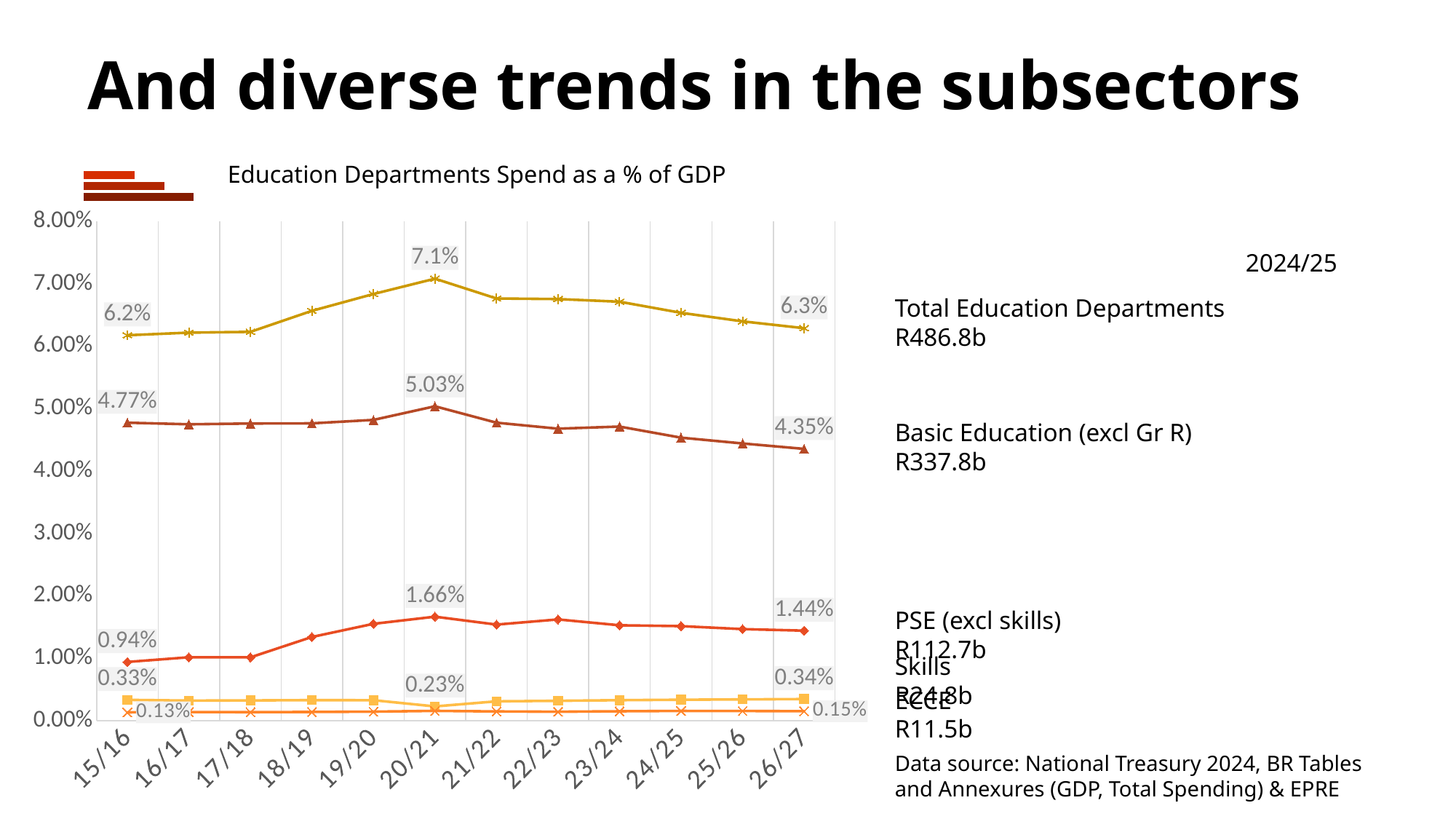
What is the Skills spend as a % of GDP in 20/21? 0.23% In which year does the Total Education Departments line reach its highest value? 20/21 How many financial years are plotted along the x axis? 12 By how many percentage points did Basic Education (excl Gr R) spend as a % of GDP fall from 20/21 to 26/27? 0.68 What is the PSE (excl skills) spend as a % of GDP in 15/16? 0.94% Does the Basic Education (excl Gr R) line rise or fall from 20/21 to 26/27? fall Is the Total Education Departments value in 19/20 greater or less than 6.00%? greater What is the Total Education Departments spend as a % of GDP in 20/21? 7.1% Which is larger in 26/27: PSE (excl skills) spend or Skills spend as a % of GDP? PSE (excl skills) What is the title of the chart? Education Departments Spend as a % of GDP What is the Basic Education (excl Gr R) spend as a % of GDP in 26/27? 4.35% What type of chart is shown on the slide? line chart